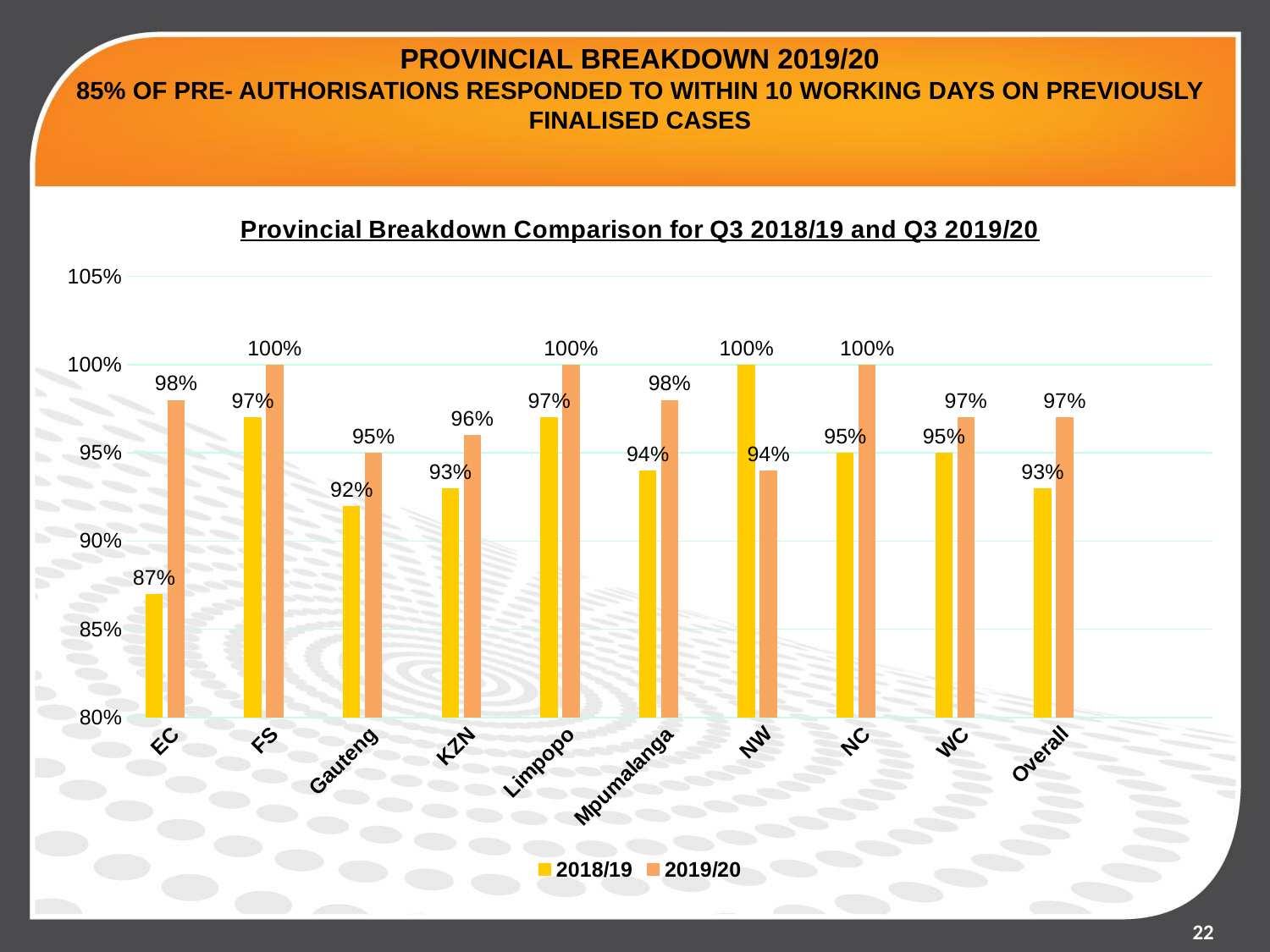
What is the 2019/20 value for Overall? 97% What kind of chart is shown on the slide? Bar chart What is the difference between the 2018/19 and 2019/20 values for NW? 6% How many series does the legend list? 2 For NW, which series has the larger value, 2018/19 or 2019/20? 2018/19 Which category has the lowest 2018/19 value? EC Which category has the lowest 2019/20 value? NW What is the title of the chart? Provincial Breakdown Comparison for Q3 2018/19 and Q3 2019/20 What is the 2018/19 value for EC? 87% How many categories are shown on the x axis? 10 What is the difference between the 2019/20 and 2018/19 values for EC? 11% What is the 2019/20 value for KZN? 96%